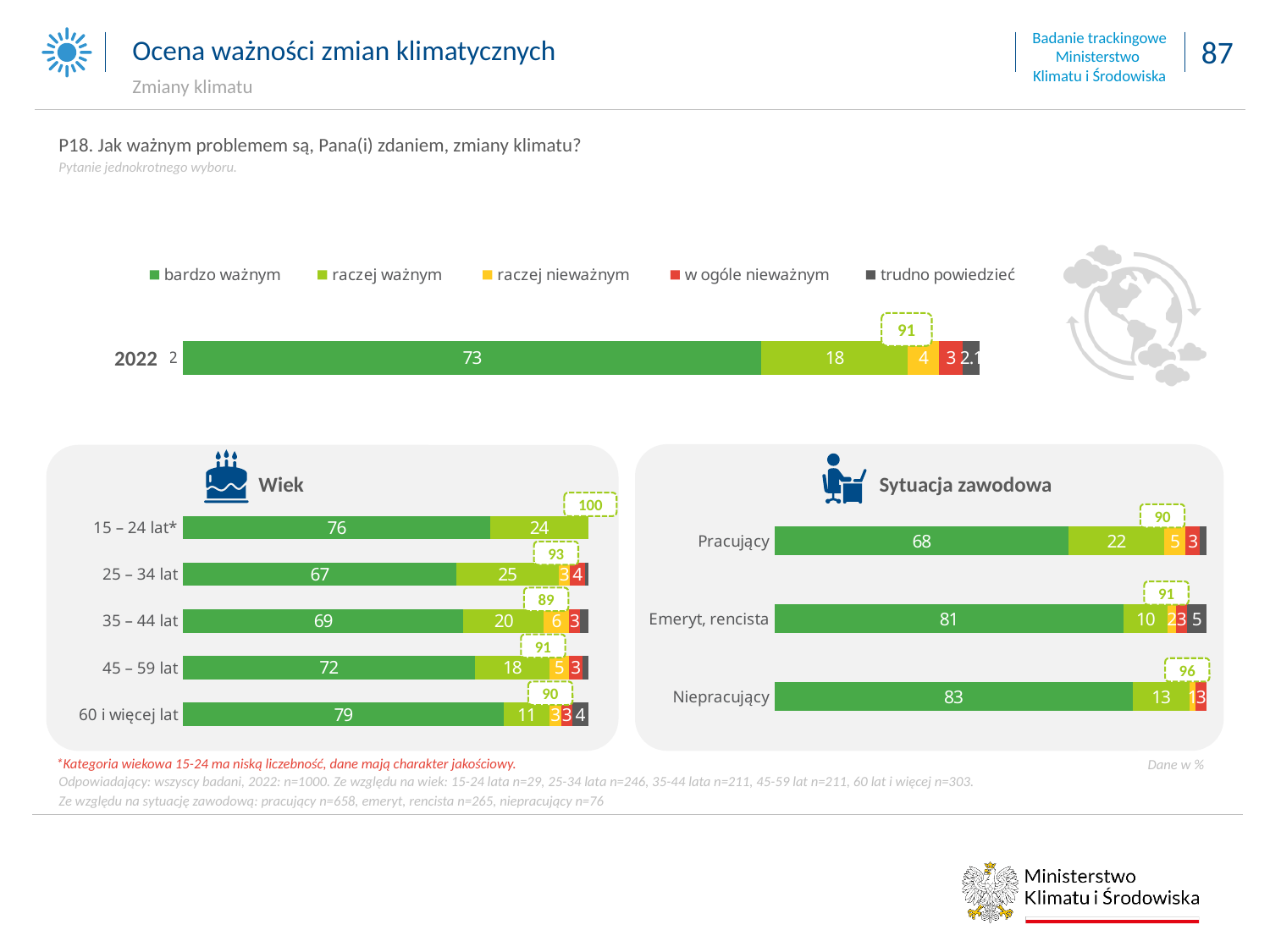
In the 'Sytuacja zawodowa' chart, what combined value is shown in the dashed box above the Niepracujący bar? 96 Which legend entry is shown in red? w ogóle nieważnym How many age groups are shown in the 'Wiek' chart? 5 In the 'Wiek' chart, which is larger: the 'raczej ważnym' value for 25 – 34 lat or for 35 – 44 lat? 25 – 34 lat In the 'Sytuacja zawodowa' chart, which group has the lowest 'bardzo ważnym' value? Pracujący In the top '2022' chart, what is the value for 'bardzo ważnym'? 73 In the 'Sytuacja zawodowa' chart, what is the 'raczej ważnym' value for Pracujący? 22 In the 'Sytuacja zawodowa' chart, what is the difference between the 'bardzo ważnym' values for Niepracujący and Pracujący? 15 In the 'Wiek' chart, what percentage of the 60 i więcej lat group answered 'bardzo ważnym'? 79 How many series does the legend list? 5 What type of chart is used on this slide? Bar chart In the 'Wiek' chart, which age group has the highest 'bardzo ważnym' value? 60 i więcej lat